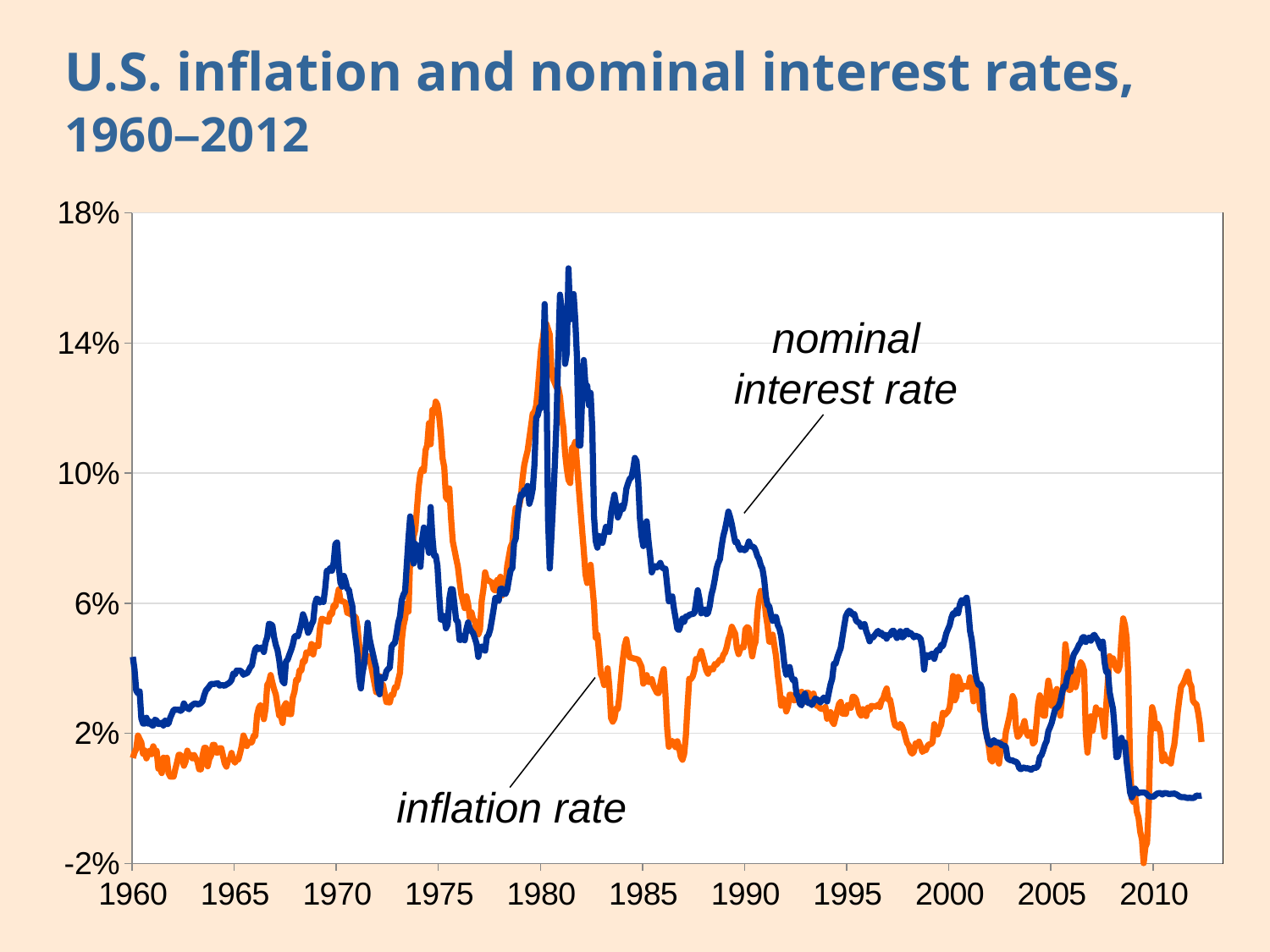
Is the inflation rate around 1975 greater or less than 10%? greater What kind of chart is shown on the slide? line chart Is the inflation rate in 1960 greater or less than 2%? less Does the nominal interest rate generally rise or fall from 1981 to 2012? fall Is the nominal interest rate around 1981 greater or less than 14%? greater Around 1981, which is higher, the nominal interest rate or the inflation rate? nominal interest rate How many series are plotted on the chart? 2 What is the title of the chart? U.S. inflation and nominal interest rates, 1960–2012 Which series reaches the highest peak on the chart? nominal interest rate Around 1975, which is higher, the inflation rate or the nominal interest rate? inflation rate Which colour is the nominal interest rate line? blue